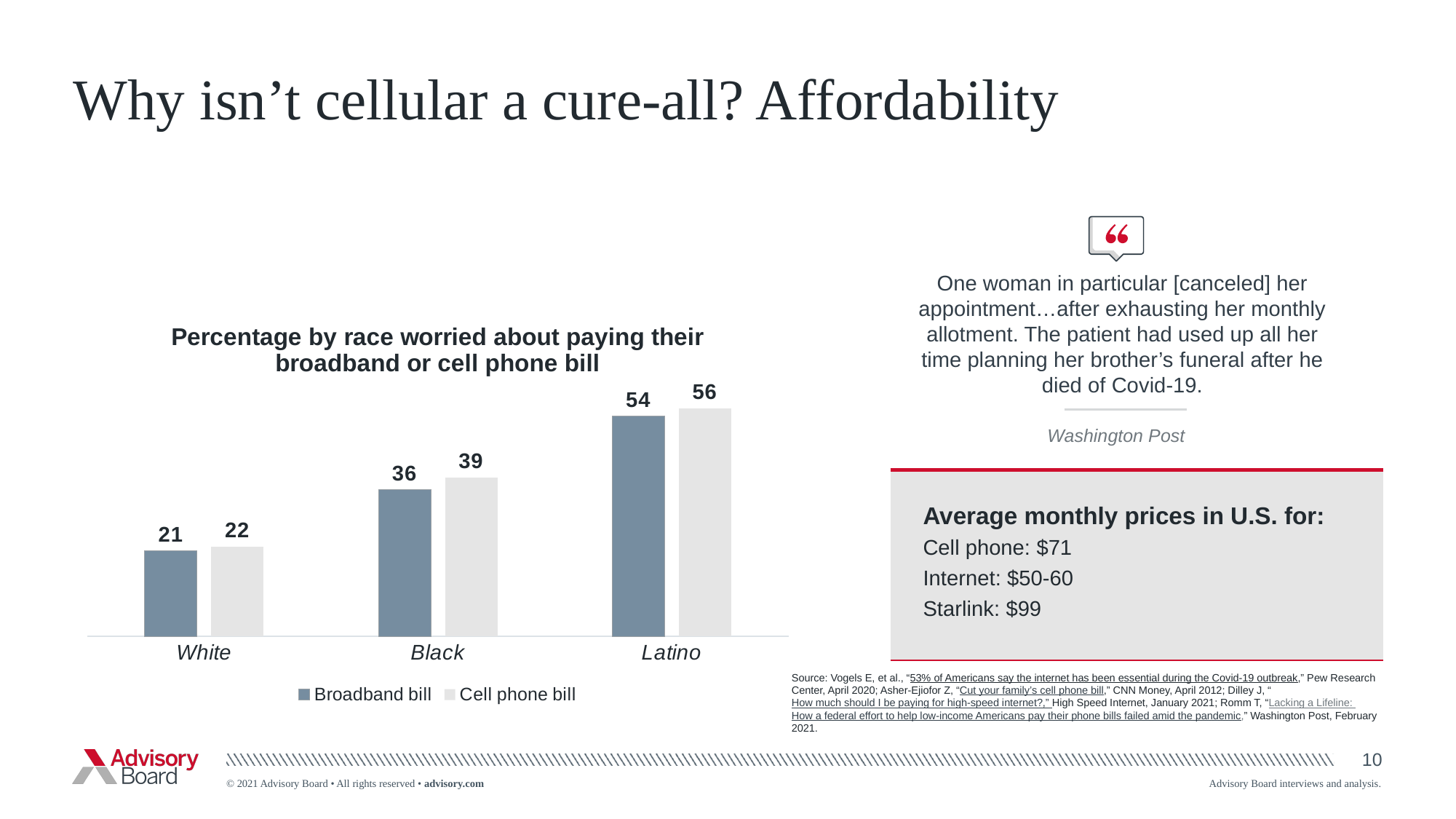
What is the difference between the Broadband bill values for Latino and White respondents? 33 How many series does the chart legend list? 2 Which race category has the lowest Broadband bill value? White Which race category has the highest Cell phone bill value? Latino What is the title of the chart? Percentage by race worried about paying their broadband or cell phone bill What kind of chart is shown on the slide? Bar chart What is the Broadband bill value for Black respondents? 36 What is the Broadband bill value for White respondents? 21 What is the Cell phone bill value for Latino respondents? 56 How many race categories are shown on the x axis of the chart? 3 Which is larger: the Broadband bill value for Latino or the Cell phone bill value for Black? Broadband bill value for Latino What is the difference between the Cell phone bill and Broadband bill values for Black respondents? 3